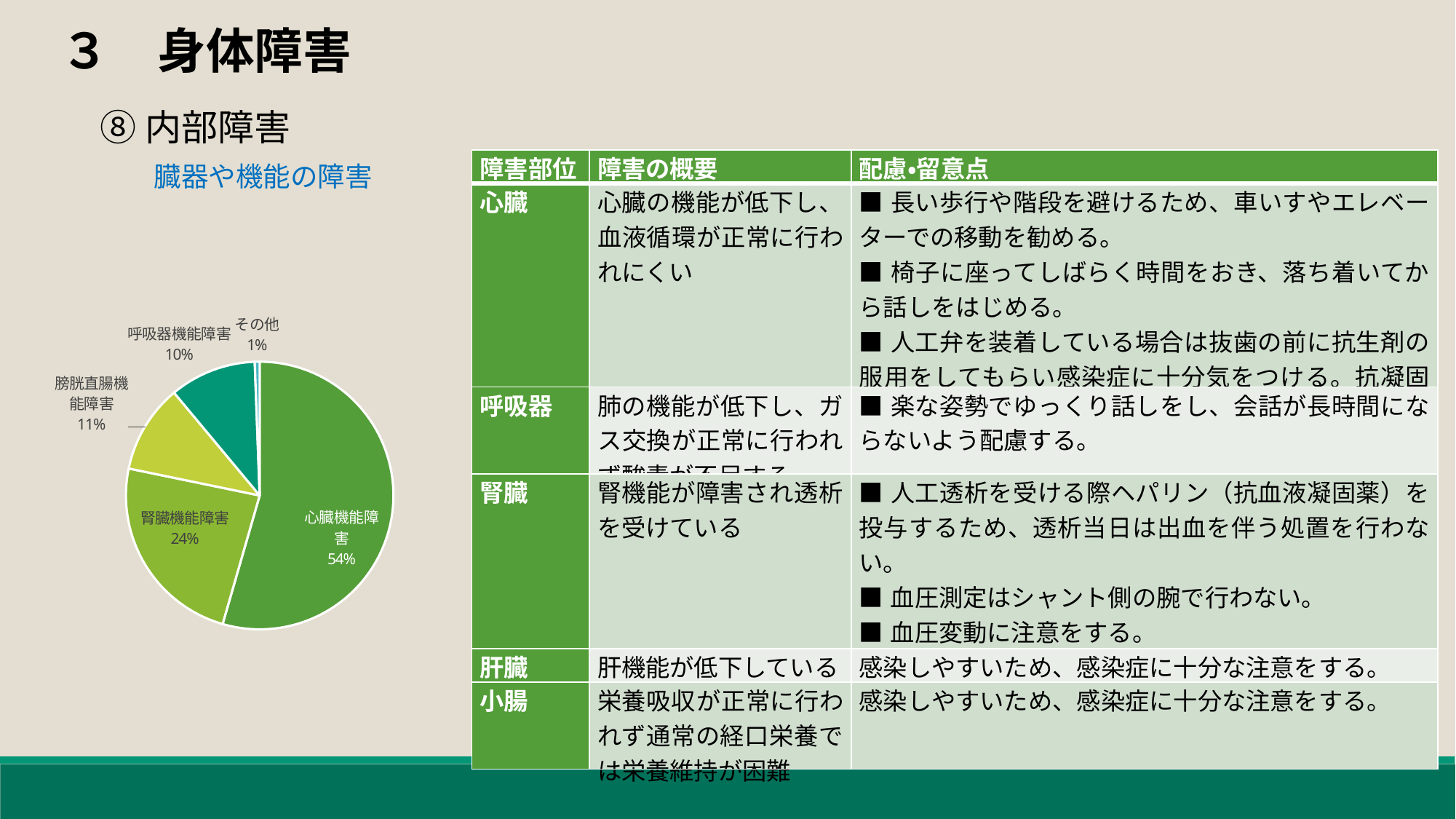
What share of the pie chart is 膀胱直腸機能障害? 11% What share of the pie chart is 心臓機能障害? 54% How many slices does the pie chart have? 5 Which slice of the pie chart is the smallest? その他 What is the difference in percentage points between 心臓機能障害 and 腎臓機能障害 in the pie chart? 30 Which slice of the pie chart is the largest? 心臓機能障害 Is the share for 心臓機能障害 in the pie chart greater or less than 50%? greater What kind of chart is shown on the slide? pie chart What share of the pie chart is 腎臓機能障害? 24% What share of the pie chart is その他? 1% Which is larger in the pie chart, 腎臓機能障害 or 呼吸器機能障害? 腎臓機能障害 What share of the pie chart is 呼吸器機能障害? 10%